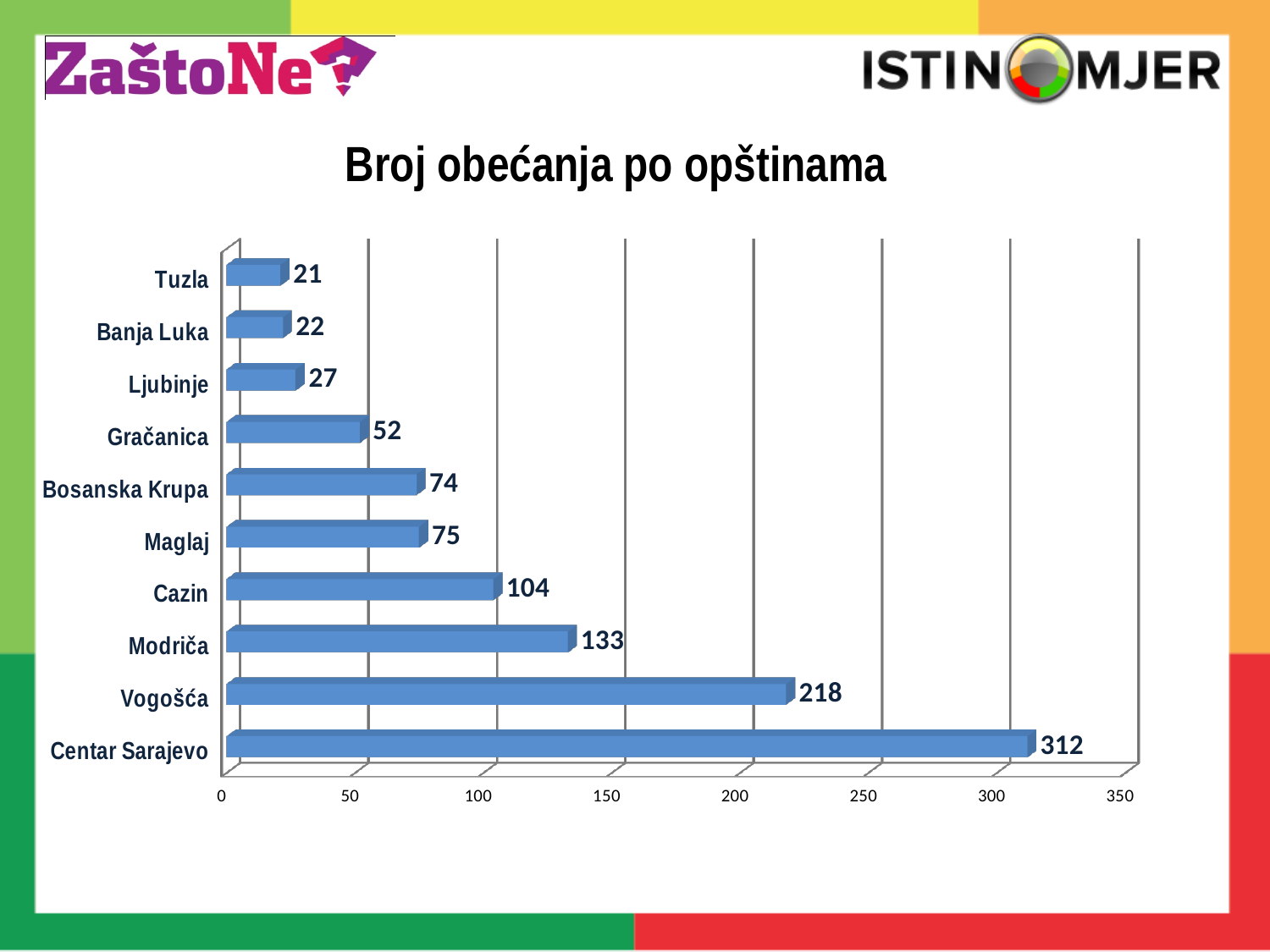
What is the value for Gračanica? 52 Which municipality has the lowest number of promises? Tuzla What is the difference between the values for Centar Sarajevo and Vogošća? 94 What is the value for Vogošća? 218 Is the value for Modriča greater or less than 150? less What is the title of the chart? Broj obećanja po opštinama Which is larger, the value for Bosanska Krupa or the value for Ljubinje? Bosanska Krupa What kind of chart is shown on the slide? bar chart What is the value for Cazin? 104 What is the difference between the values for Modriča and Cazin? 29 Which municipality has the highest number of promises? Centar Sarajevo How many municipalities are shown in the chart? 10